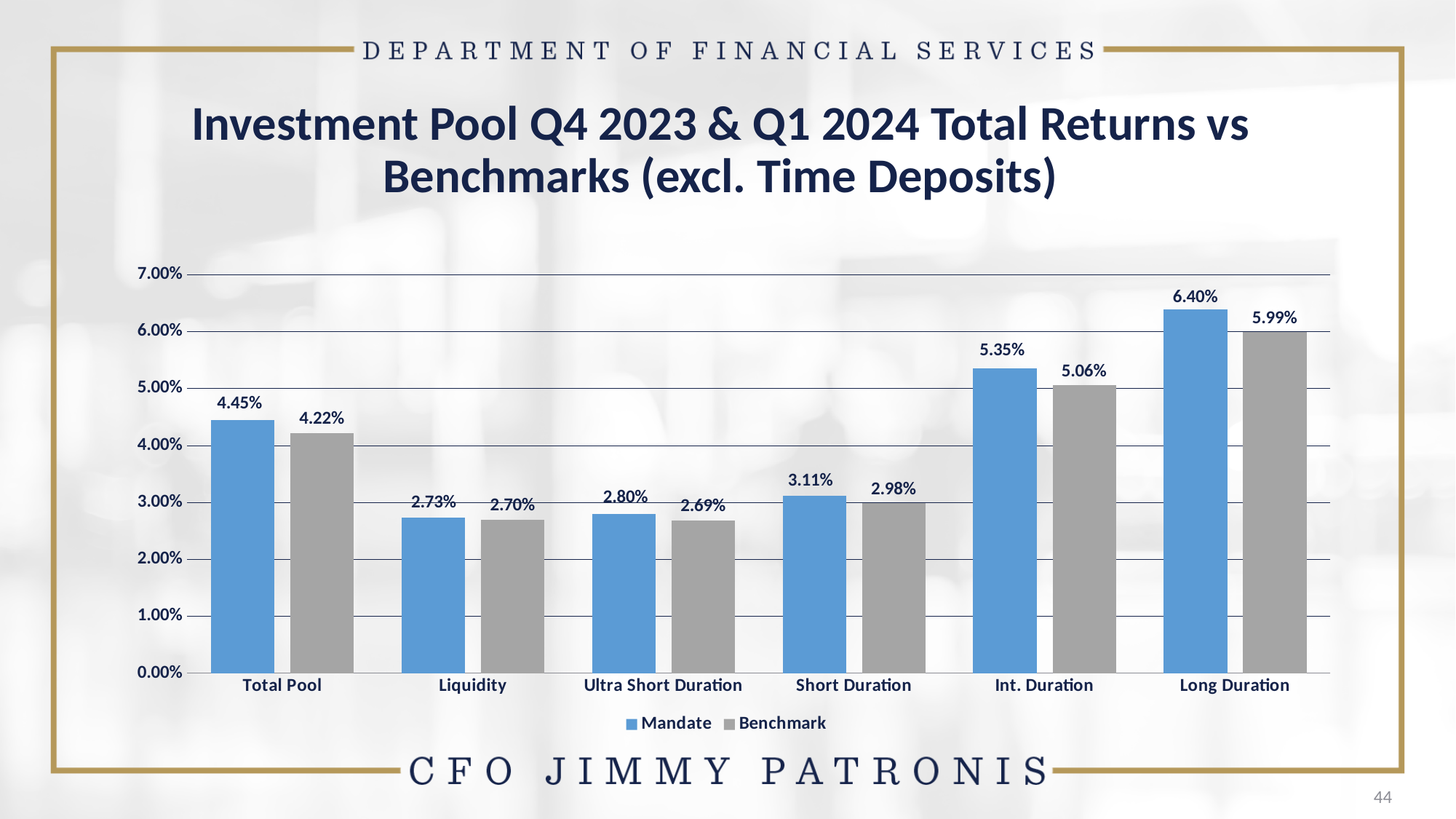
How many categories are shown on the x axis? 6 What kind of chart is shown on the slide? bar chart Which category has the lowest Benchmark value? Ultra Short Duration How many series does the legend list? 2 What is the Benchmark value for Long Duration? 5.99% Is the Benchmark value for Int. Duration greater or less than 5.00%? greater What is the Benchmark value for Ultra Short Duration? 2.69% What is the difference between the Mandate and Benchmark values for Int. Duration? 0.29% Which is larger, the Mandate value for Short Duration or the Mandate value for Ultra Short Duration? Short Duration What is the Mandate value for Total Pool? 4.45% Which series is shown in blue? Mandate Which category has the highest Mandate value? Long Duration